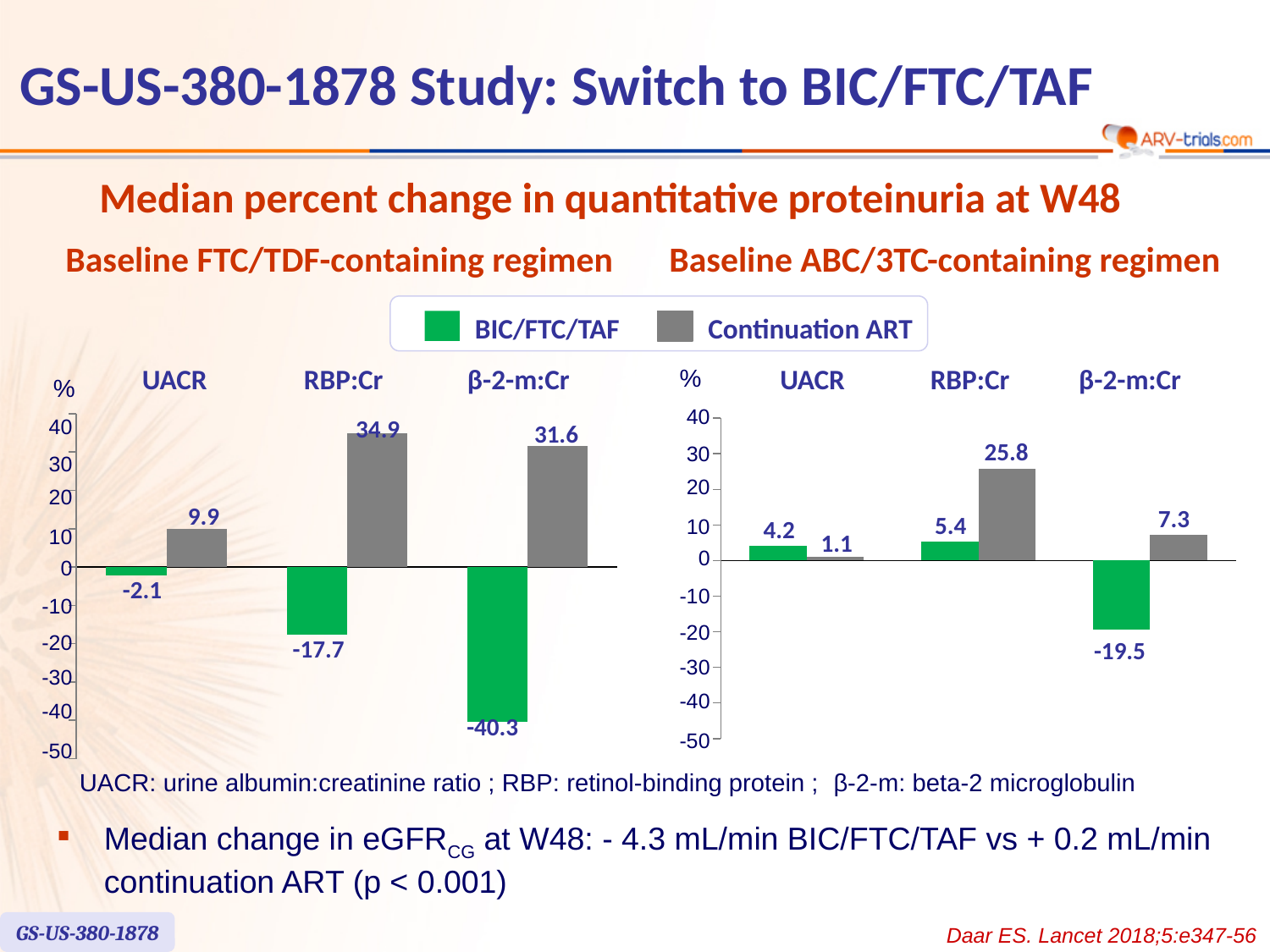
How many series does the legend list? 2 In the Baseline FTC/TDF-containing regimen chart, which category has the highest Continuation ART value? RBP:Cr What colour represents Continuation ART in the legend? Grey In the Baseline FTC/TDF-containing regimen chart, what is the difference between the Continuation ART and BIC/FTC/TAF values for RBP:Cr? 52.6 What kind of chart is the Baseline FTC/TDF-containing regimen chart? Bar chart In the Baseline ABC/3TC-containing regimen chart, what is the value for BIC/FTC/TAF for UACR? 4.2 In the Baseline ABC/3TC-containing regimen chart, which is larger for UACR: BIC/FTC/TAF or Continuation ART? BIC/FTC/TAF In the Baseline FTC/TDF-containing regimen chart, what is the value for BIC/FTC/TAF for β-2-m:Cr? -40.3 In the Baseline FTC/TDF-containing regimen chart, what is the value for Continuation ART for UACR? 9.9 In the Baseline ABC/3TC-containing regimen chart, which category has the lowest BIC/FTC/TAF value? β-2-m:Cr In the Baseline ABC/3TC-containing regimen chart, what is the value for Continuation ART for RBP:Cr? 25.8 How many categories are shown on the x axis of the Baseline ABC/3TC-containing regimen chart? 3